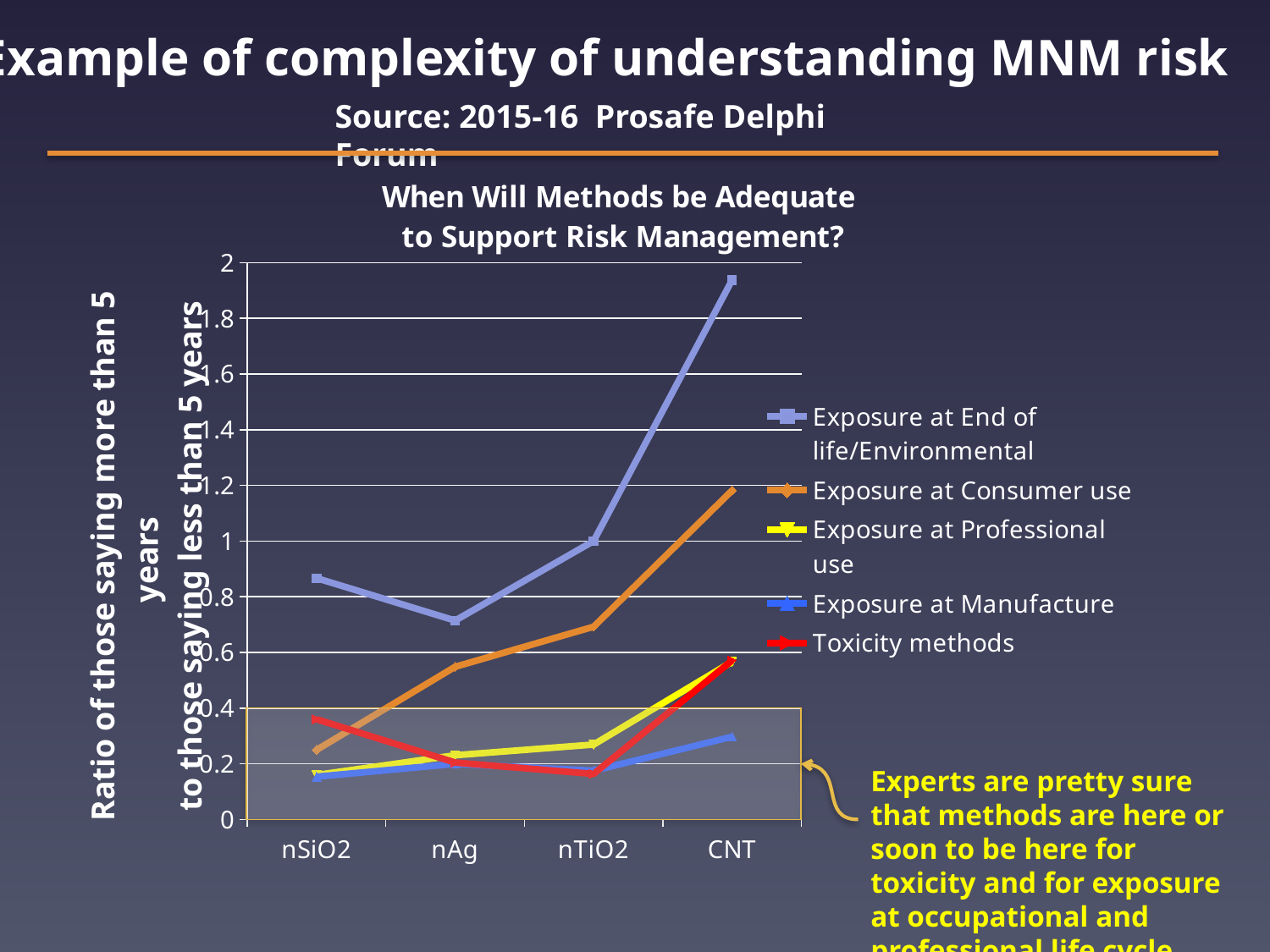
Is the value for Exposure at Consumer use at CNT greater or less than 1? greater For the Exposure at Consumer use series, which category has the lowest value? nSiO2 Is the value for Exposure at End of life/Environmental at nAg greater or less than 0.8? less Do the values for Exposure at Consumer use rise or fall from nSiO2 to CNT? rise How many series does the chart's legend list? 5 How many categories are shown on the x axis of the chart? 4 Which series has the highest value at CNT? Exposure at End of life/Environmental What kind of chart is shown on the slide? line chart Is the value for Exposure at End of life/Environmental at CNT greater or less than 1.8? greater For the Exposure at End of life/Environmental series, which category has the highest value? CNT What is the title of the chart? When Will Methods be Adequate to Support Risk Management?